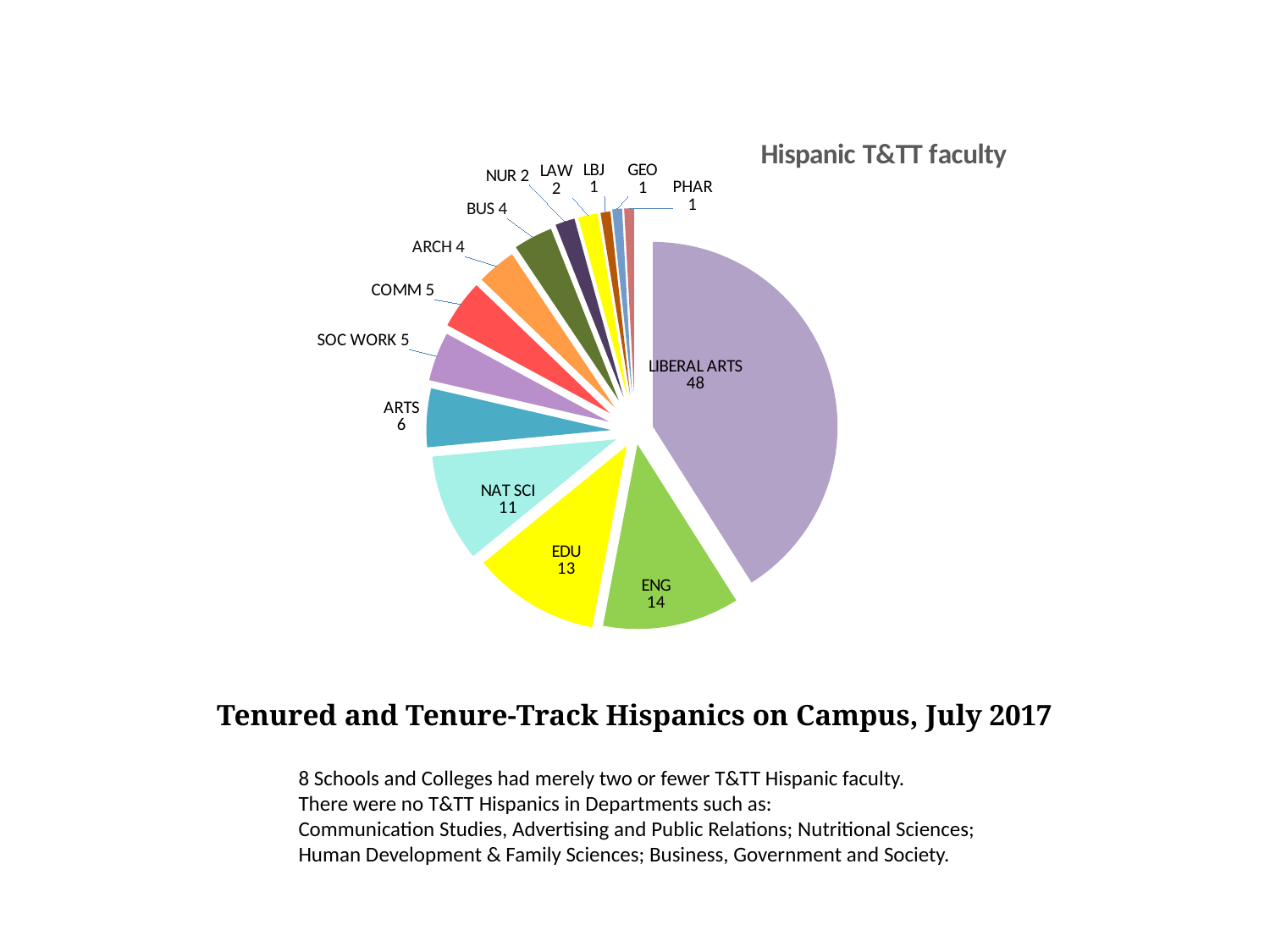
How many Hispanic T&TT faculty are in LIBERAL ARTS? 48 What kind of chart is shown on the slide? pie chart What is the value for SOC WORK? 5 Which category has a larger value, EDU or ARTS? EDU What is the value for NAT SCI? 11 What is the difference between the values for LIBERAL ARTS and ENG? 34 Which categories have a value of 1? LBJ, GEO, PHAR How many categories (slices) does the pie chart have? 14 What is the title of the chart? Hispanic T&TT faculty What is the value for ENG? 14 Which category has the largest slice of the pie? LIBERAL ARTS What is the difference between the values for NAT SCI and ARCH? 7